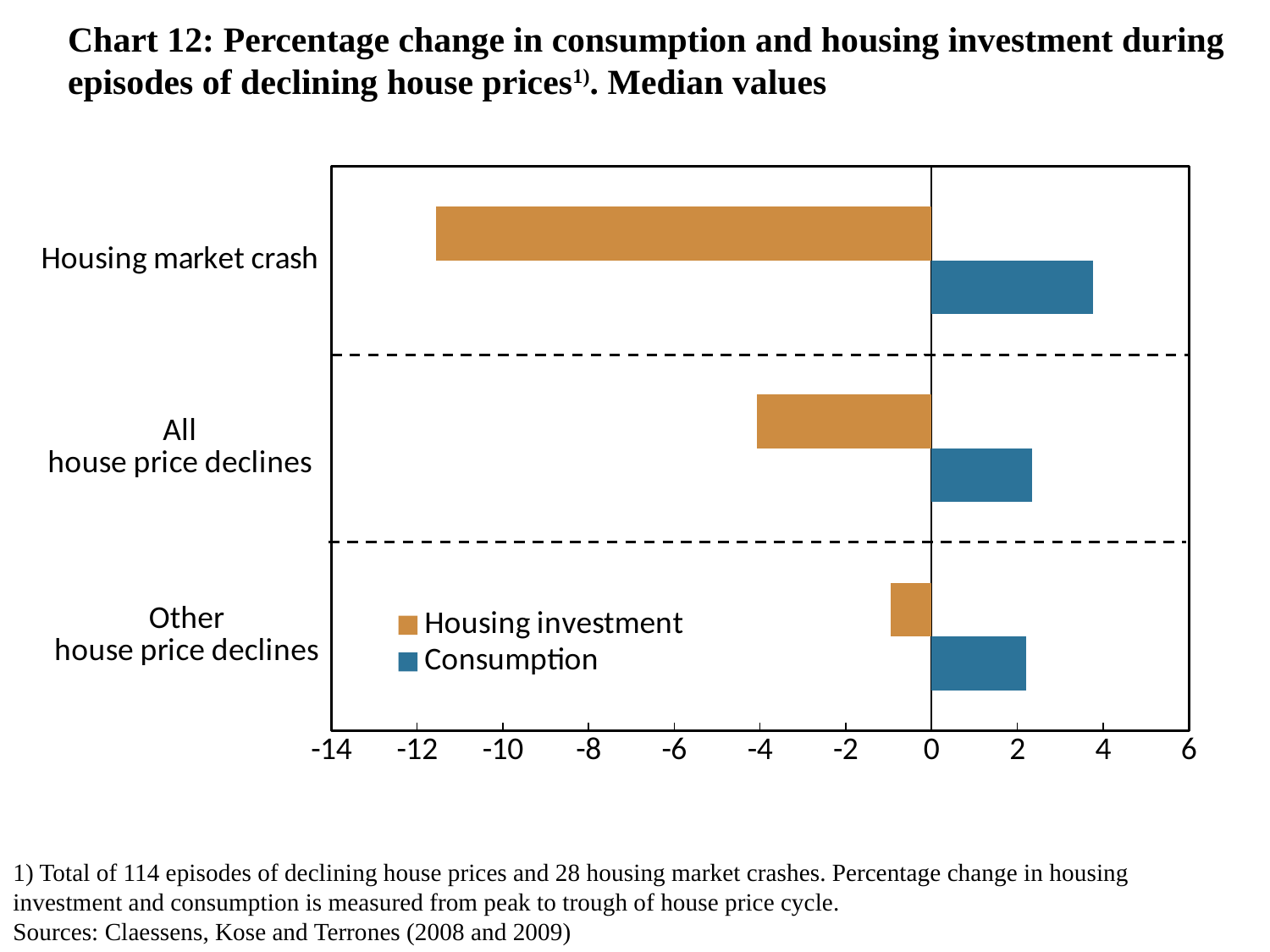
Which category has the highest Consumption value? Housing market crash Is the Housing investment value for Housing market crash greater or less than -10? less Is the Consumption value for All house price declines greater or less than 4? less Is the Housing investment value for Other house price declines greater or less than -2? greater What kind of chart is shown on the slide? bar chart How many series does the legend list? 2 What is the chart number given in the title? Chart 12 Which has the lower Housing investment value: All house price declines or Other house price declines? All house price declines Which series is shown in orange? Housing investment How many categories are shown on the chart? 3 Which category has the lowest (most negative) Housing investment value? Housing market crash